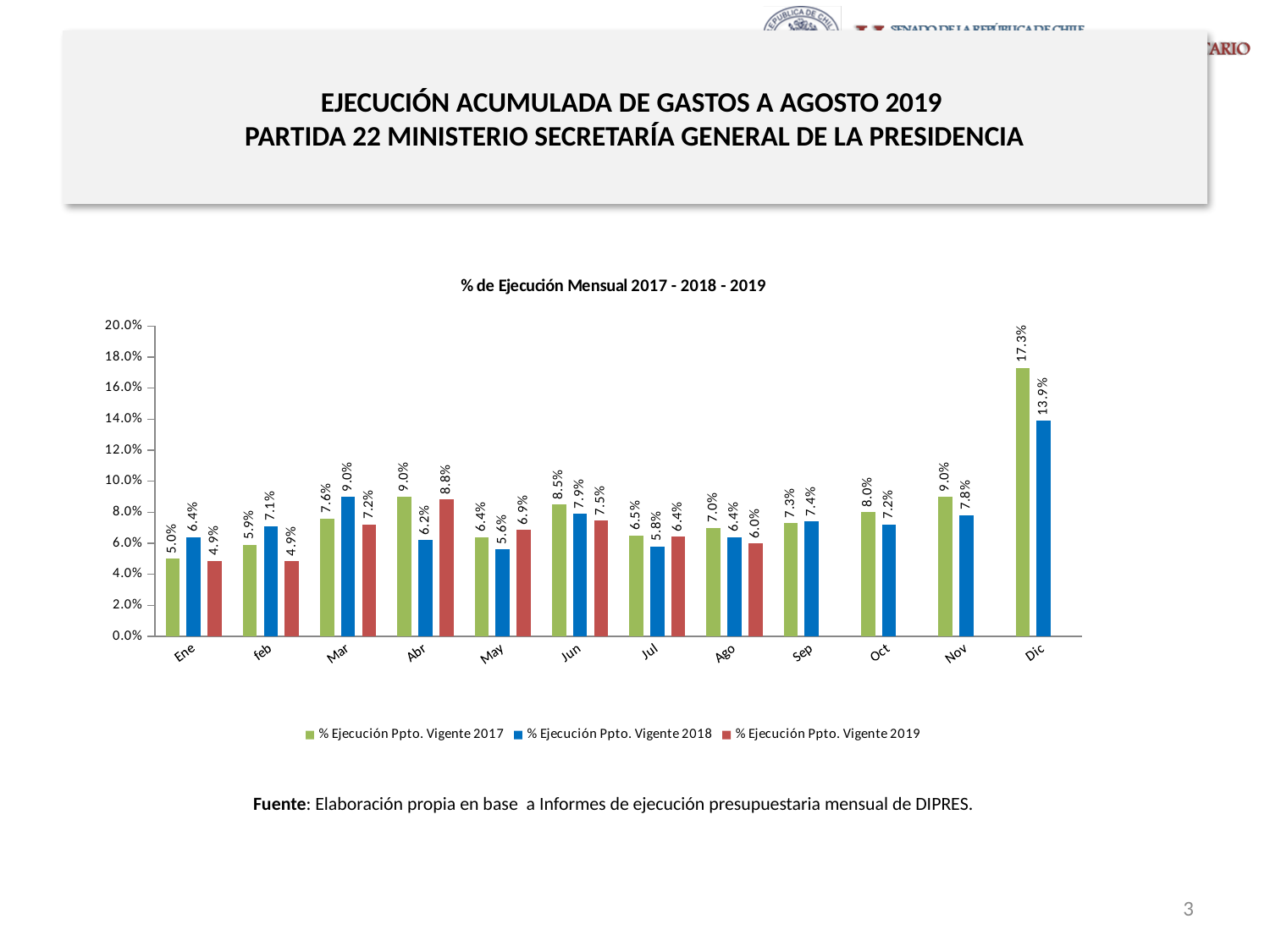
What is the last month for which a % Ejecución Ppto. Vigente 2019 value is plotted? Ago In which month is the % Ejecución Ppto. Vigente 2017 value lowest? Ene What is the value of % Ejecución Ppto. Vigente 2018 for Mar? 9.0% How many series does the legend list? 3 In which month is the % Ejecución Ppto. Vigente 2018 value highest? Dic What is the difference between the 2017 and 2018 values for Dic? 3.4% What is the value of % Ejecución Ppto. Vigente 2019 for Abr? 8.8% Which is larger for Jun: the 2017 value or the 2019 value? 2017 value How many months are shown on the x axis? 12 What is the value of % Ejecución Ppto. Vigente 2017 for Dic? 17.3% What type of chart is shown on the slide? bar chart What is the title of the chart? % de Ejecución Mensual 2017 - 2018 - 2019